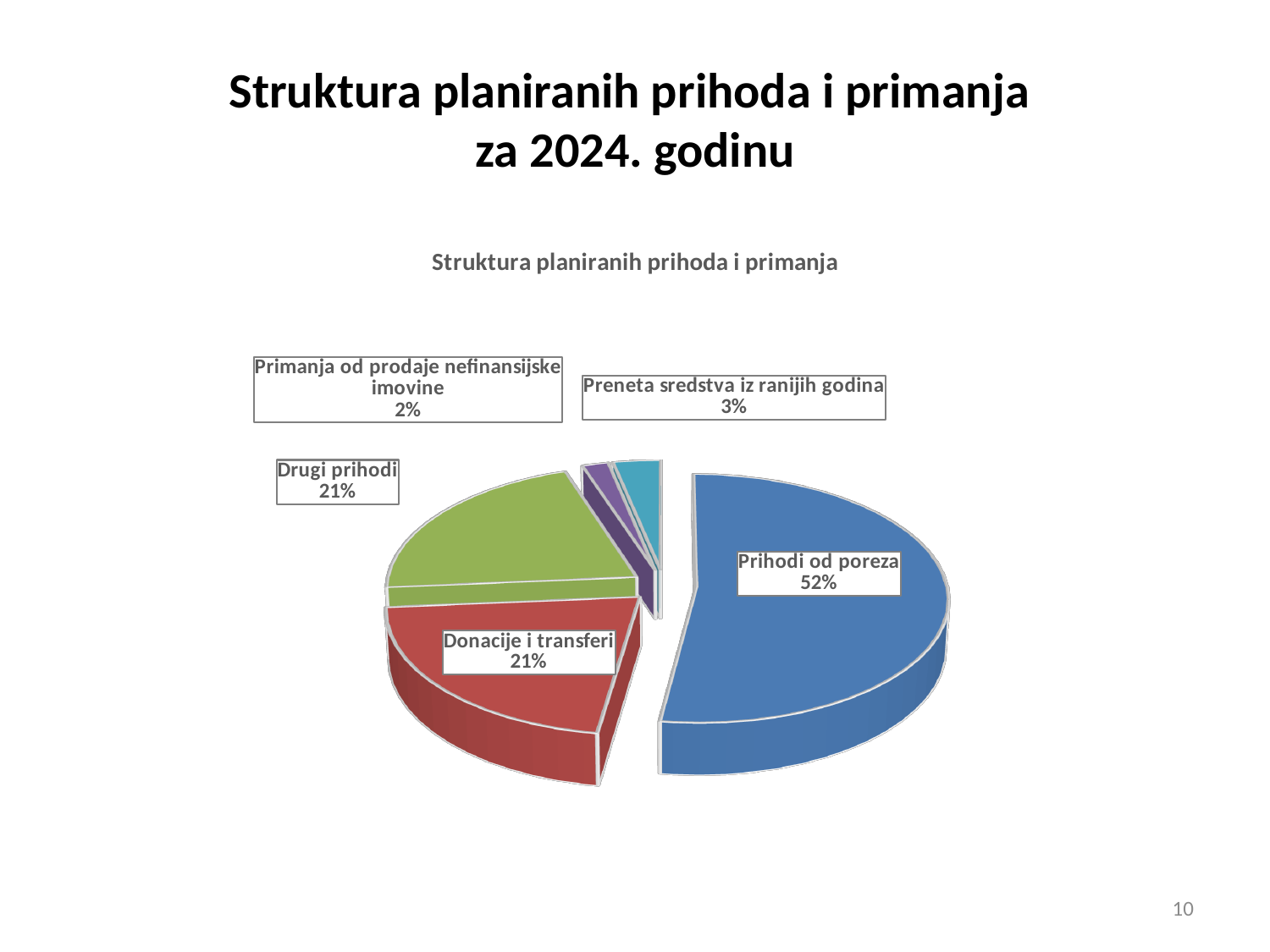
What share of the pie does Primanja od prodaje nefinansijske imovine have? 2% What is the difference in percentage points between Prihodi od poreza and Donacije i transferi? 31 What share of the pie does Prihodi od poreza have? 52% How many slices does the pie chart have? 5 What share of the pie does Preneta sredstva iz ranijih godina have? 3% Which category has the largest share of the pie? Prihodi od poreza Which is larger, the share for Preneta sredstva iz ranijih godina or the share for Primanja od prodaje nefinansijske imovine? Preneta sredstva iz ranijih godina Which category has the smallest share of the pie? Primanja od prodaje nefinansijske imovine What is the title of the chart? Struktura planiranih prihoda i primanja What kind of chart is shown on the slide? Pie chart